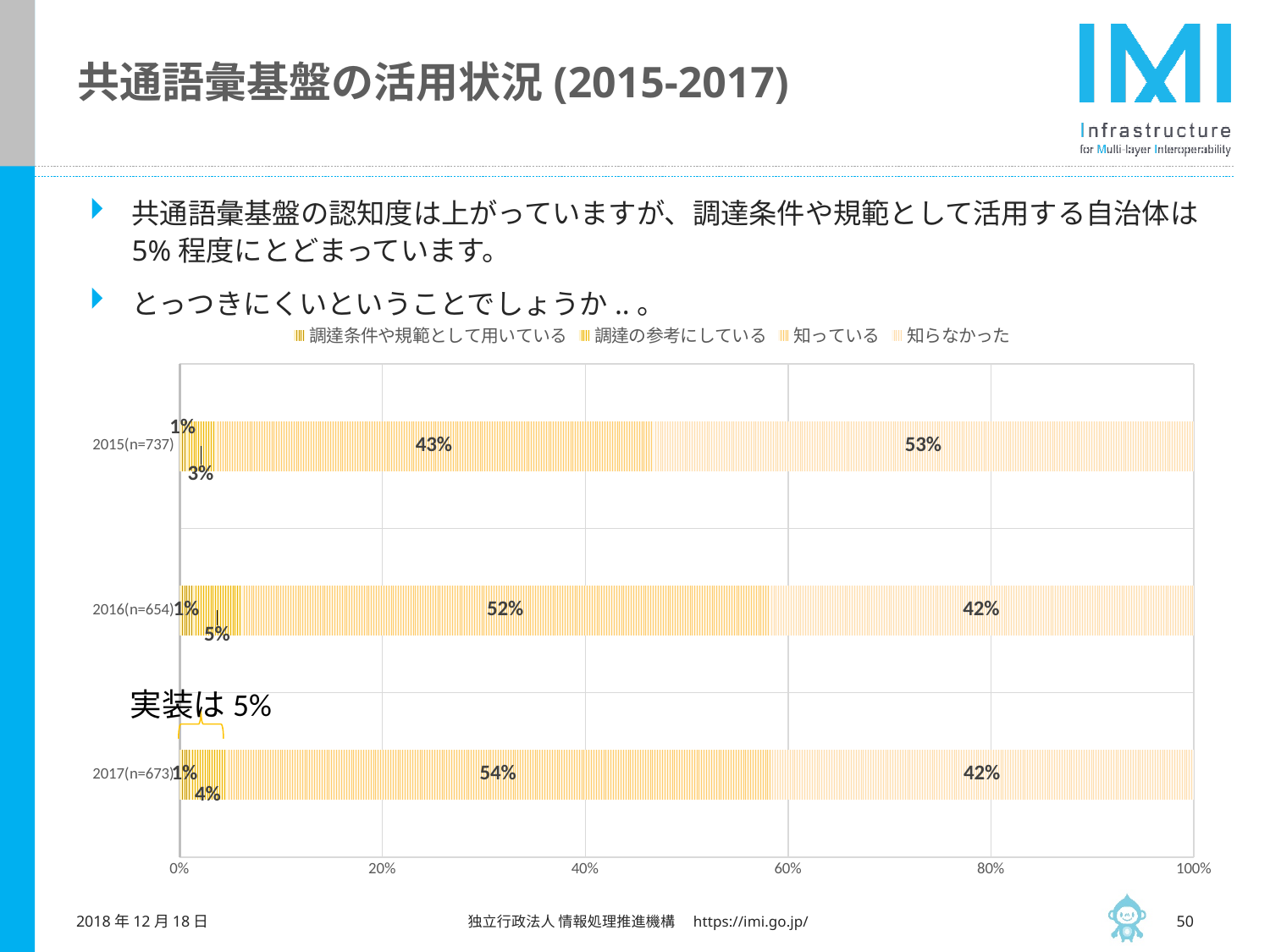
What is the difference between the 知っている values for 2017(n=673) and 2015(n=737)? 11% Does the 知らなかった value rise or fall from 2015 to 2017? fall Which year has the lowest value for 知っている? 2015(n=737) Which year has the highest value for 知らなかった? 2015(n=737) What kind of chart is shown on the slide? stacked bar chart What is the value for 知っている in 2015(n=737)? 43% Is the 知っている value larger in 2016(n=654) or in 2017(n=673)? 2017(n=673) What is the value for 調達の参考にしている in 2016(n=654)? 5% How many series does the legend list? 4 What is the value for 知らなかった in 2016(n=654)? 42% What is the value for 調達の参考にしている in 2017(n=673)? 4% How many categories (years) are plotted on the chart? 3